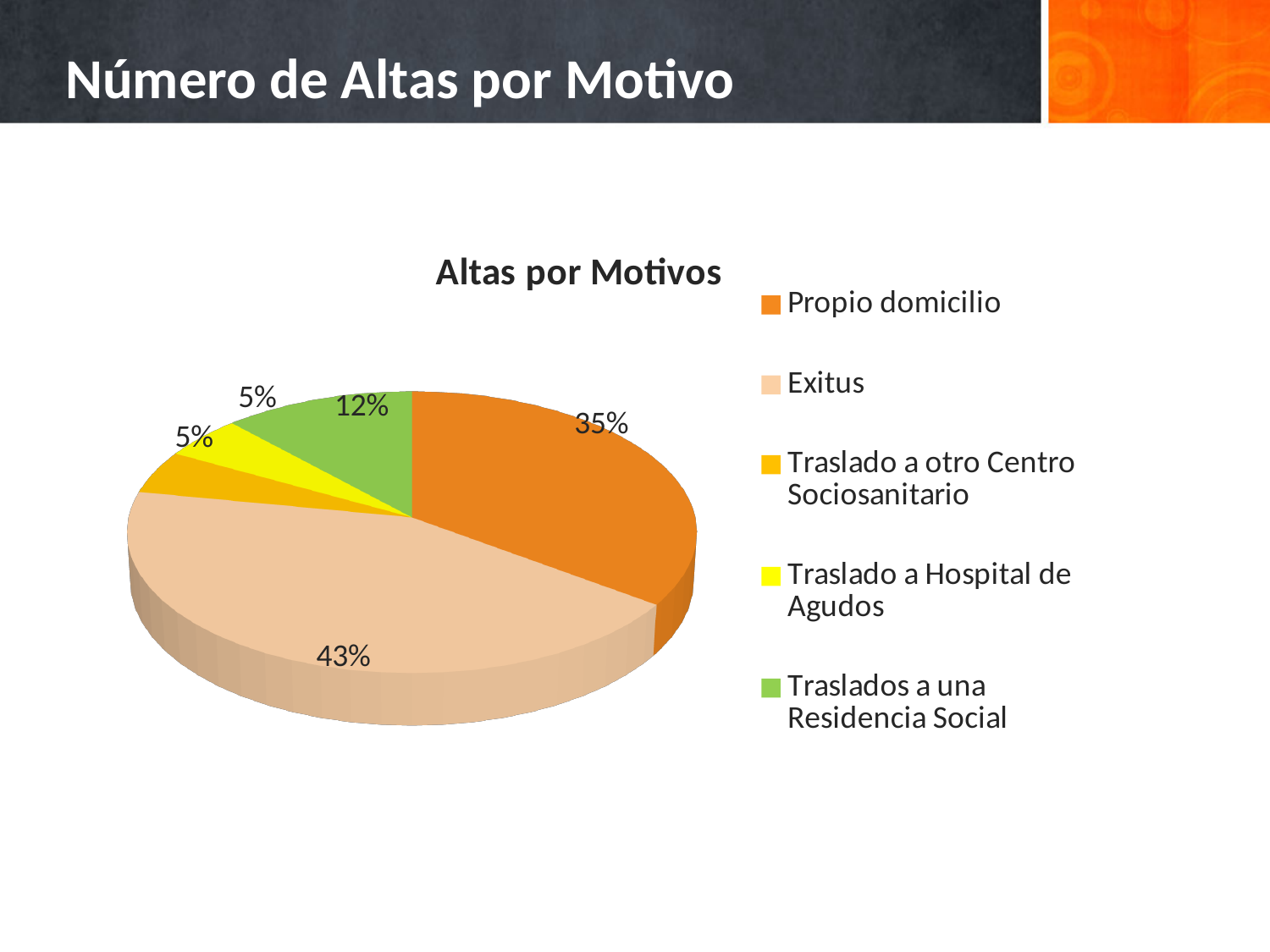
Which category has the largest slice of the pie? Exitus What share of the pie does Propio domicilio represent? 35% What is the combined share of Traslado a otro Centro Sociosanitario and Traslado a Hospital de Agudos? 10% Which is larger, the share for Propio domicilio or the share for Traslados a una Residencia Social? Propio domicilio What is the title of the chart? Altas por Motivos What share of the pie does Exitus represent? 43% What is the difference in percentage points between Exitus and Propio domicilio? 8 How many categories does the legend list? 5 What kind of chart is shown on the slide? Pie chart What share of the pie does Traslados a una Residencia Social represent? 12% What colour is the slice for Traslados a una Residencia Social? Green